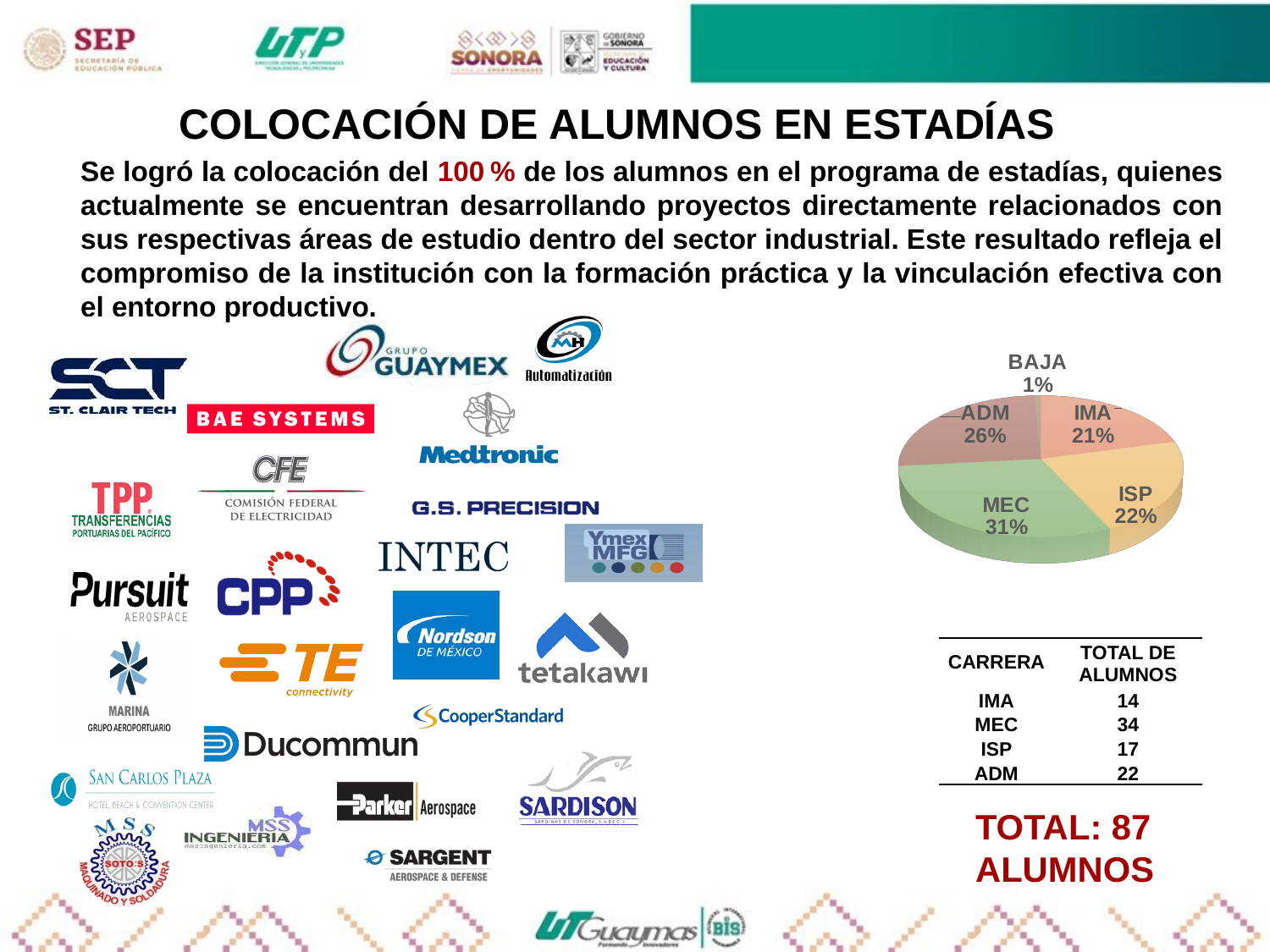
Which category has the largest slice in the pie chart? MEC Which slice is larger in the pie chart, ADM or ISP? ADM What share of the pie chart does BAJA represent? 1% What share of the pie chart does MEC represent? 31% Which category has the smallest slice in the pie chart? BAJA What is the difference in percentage points between the ISP and IMA slices? 1 What is the difference in percentage points between the MEC and ADM slices? 5 What kind of chart is shown on the slide? pie chart What share of the pie chart does ISP represent? 22% What share of the pie chart does IMA represent? 21% How many slices does the pie chart have? 5 What share of the pie chart does ADM represent? 26%